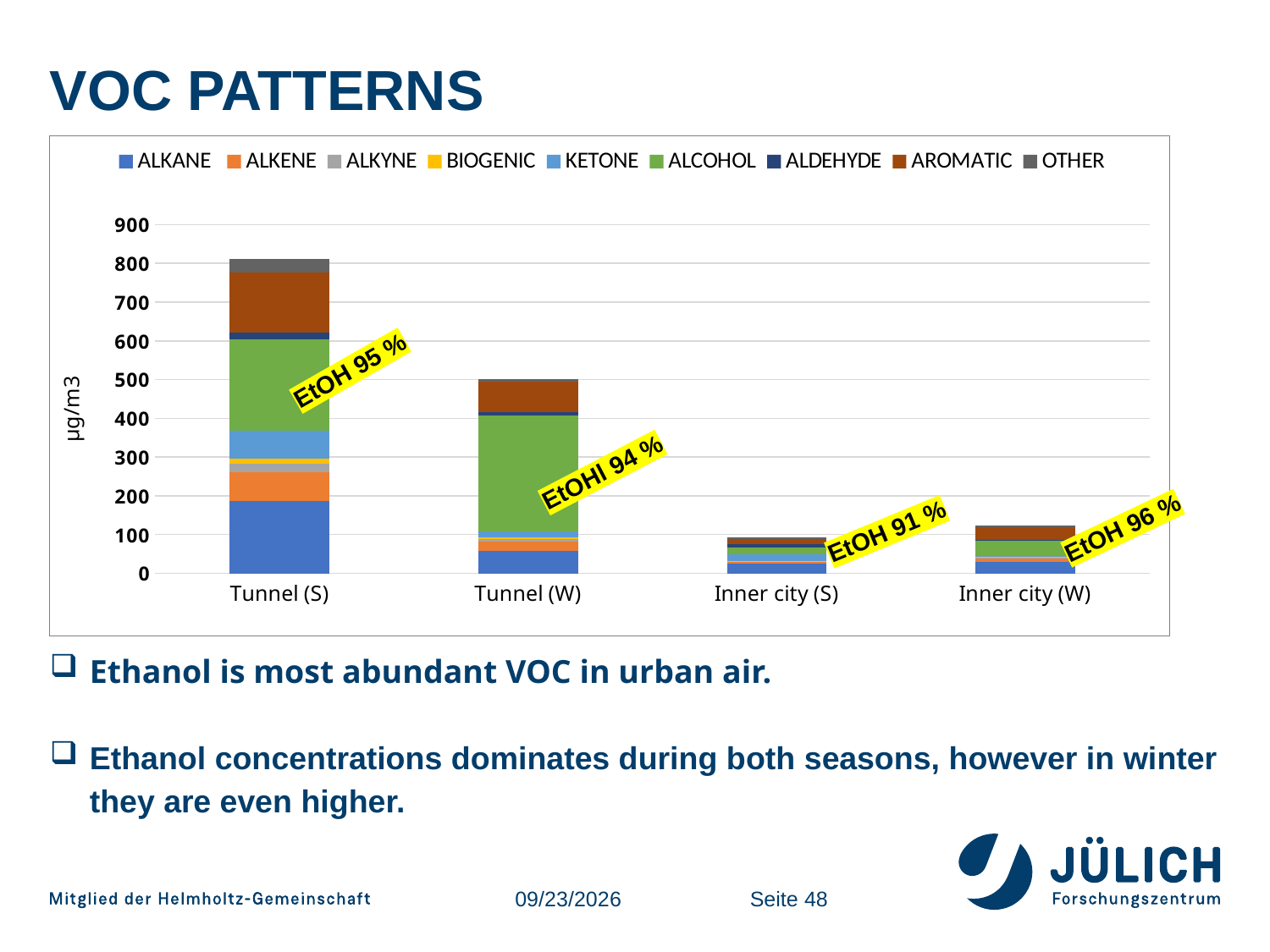
What type of chart is shown on the slide? Stacked bar chart Which has a larger total bar, Inner city (S) or Inner city (W)? Inner city (W) Is the total value for Inner city (S) greater or less than 100? less How many series does the chart legend list? 9 What is the label on the y axis of the chart? µg/m3 Is the total value for Tunnel (W) greater or less than 400? greater How many categories are shown on the x axis of the chart? 4 Which category has the lowest total stacked bar? Inner city (S) What EtOH percentage is annotated next to the Inner city (W) bar? EtOH 96 % Which has a larger total bar, Tunnel (S) or Tunnel (W)? Tunnel (S) Which category has the highest total stacked bar? Tunnel (S) Is the total value for Tunnel (S) greater or less than 700? greater